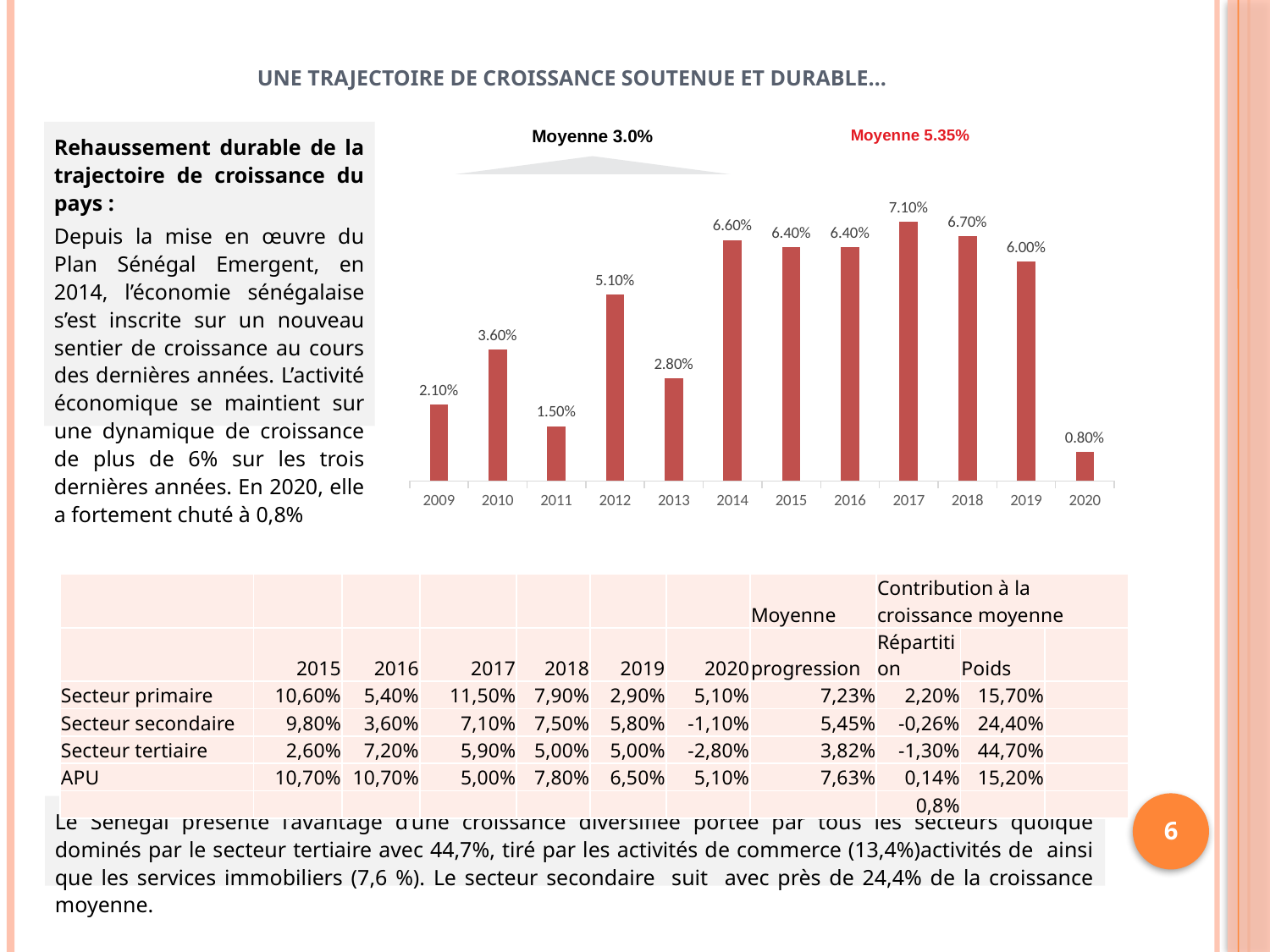
What type of chart is shown on the slide? Bar chart Which is larger in the bar chart, the value for 2010 or the value for 2011? 2010 How many years are shown on the x axis of the bar chart? 12 Which year has the lowest value in the bar chart? 2020 Which year has the highest value in the bar chart? 2017 What is the value shown for 2012 in the bar chart? 5.10% What is the value shown for 2020 in the bar chart? 0.80% Do the values in the bar chart rise or fall from 2017 to 2020? Fall What is the difference between the values for 2019 and 2020 in the bar chart? 5.20% What is the value shown for 2017 in the bar chart? 7.10% What is the difference between the values for 2014 and 2013 in the bar chart? 3.80% What average (Moyenne) is annotated in red above the right part of the bar chart? Moyenne 5.35%